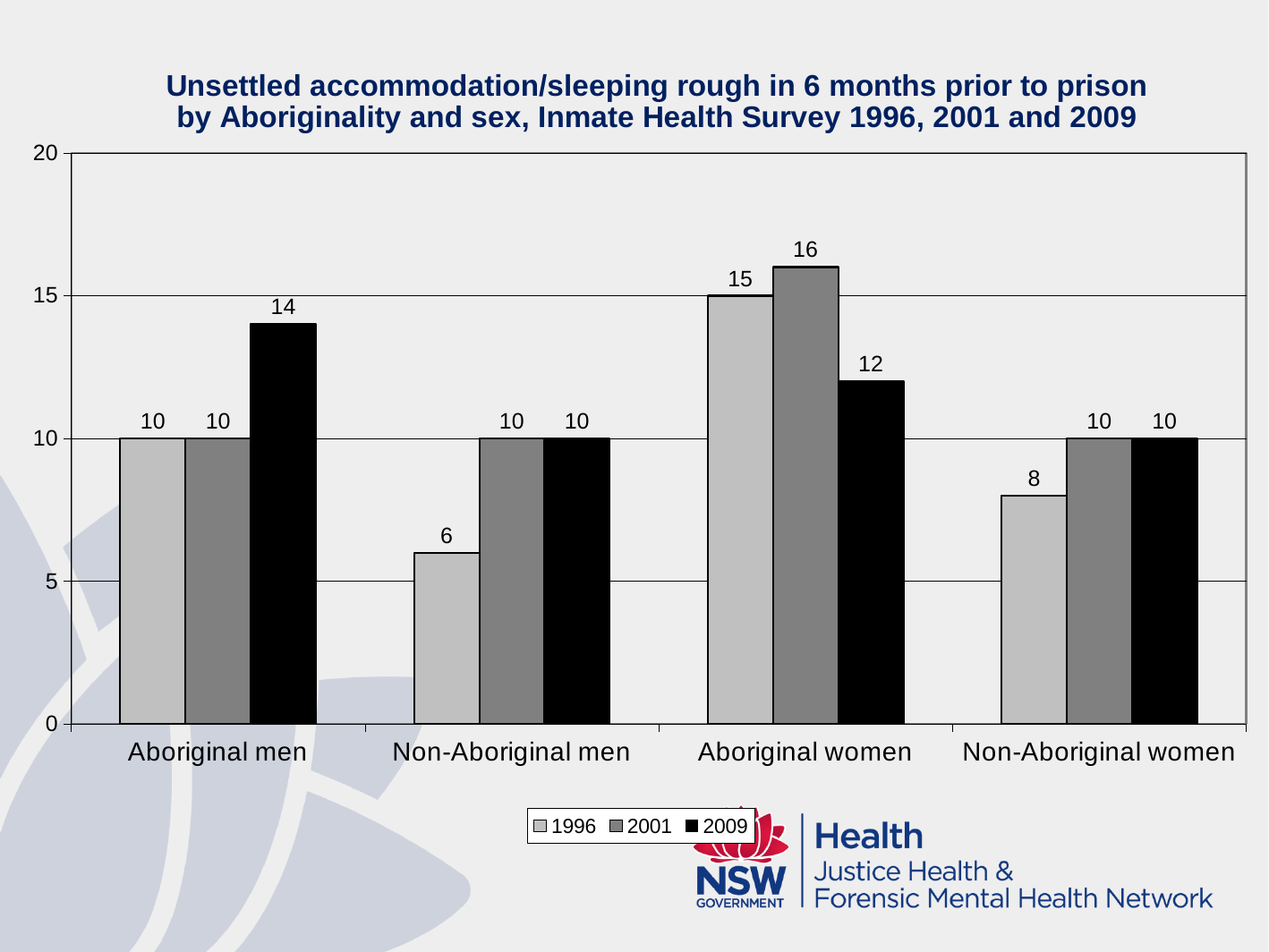
What kind of chart is shown on the slide? Bar chart Which series is shown in black in the legend? 2009 How many categories are shown on the x axis? 4 What is the value for Aboriginal men in 2009? 14 What is the value for Aboriginal women in 2001? 16 Which category has the highest value in the 2001 series? Aboriginal women Which category has the lowest value in the 1996 series? Non-Aboriginal men How many series does the legend list? 3 What is the difference between the 2001 and 2009 values for Aboriginal women? 4 What is the value for Non-Aboriginal women in 1996? 8 Which is larger: the 2009 value for Aboriginal men or the 2009 value for Aboriginal women? Aboriginal men What is the value for Non-Aboriginal men in 1996? 6